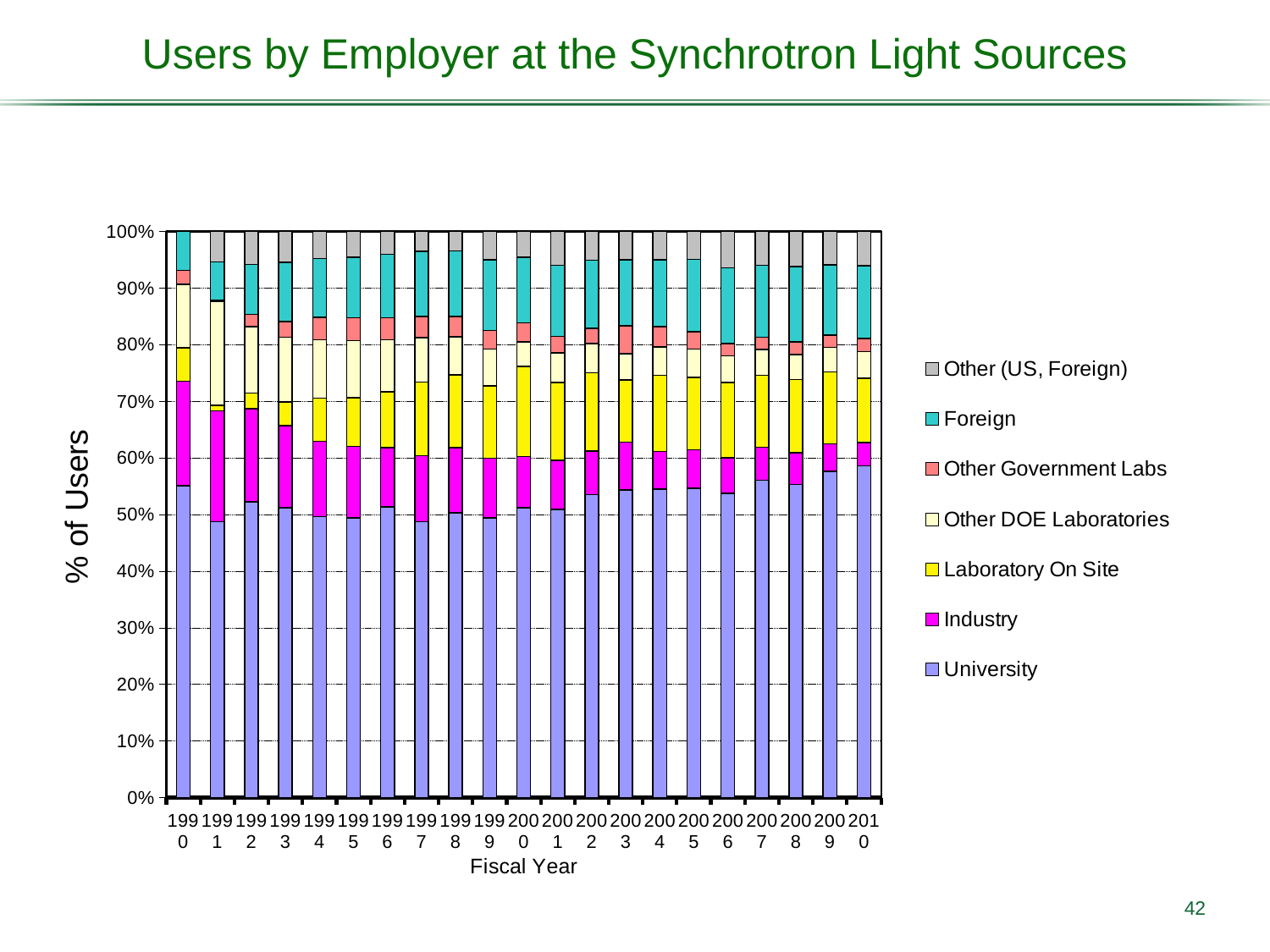
Is the University share of users in fiscal year 2009 greater or less than 50%? greater Is the University share of users in fiscal year 2010 greater or less than 50%? greater How many fiscal years are plotted along the x axis? 21 What is the title of the chart? Users by Employer at the Synchrotron Light Sources Is the Industry share of users larger in fiscal year 1990 or in fiscal year 2010? 1990 Which is larger in fiscal year 1990, the University share or the Industry share? University How many series does the legend list? 7 Which employer category makes up the largest share of users in every fiscal year? University Is the University share of users in fiscal year 1990 greater or less than 50%? greater Does the Industry share of users rise or fall from fiscal year 1990 to fiscal year 2010? fall What is the label on the y axis? % of Users What kind of chart is shown on the slide? Stacked bar chart